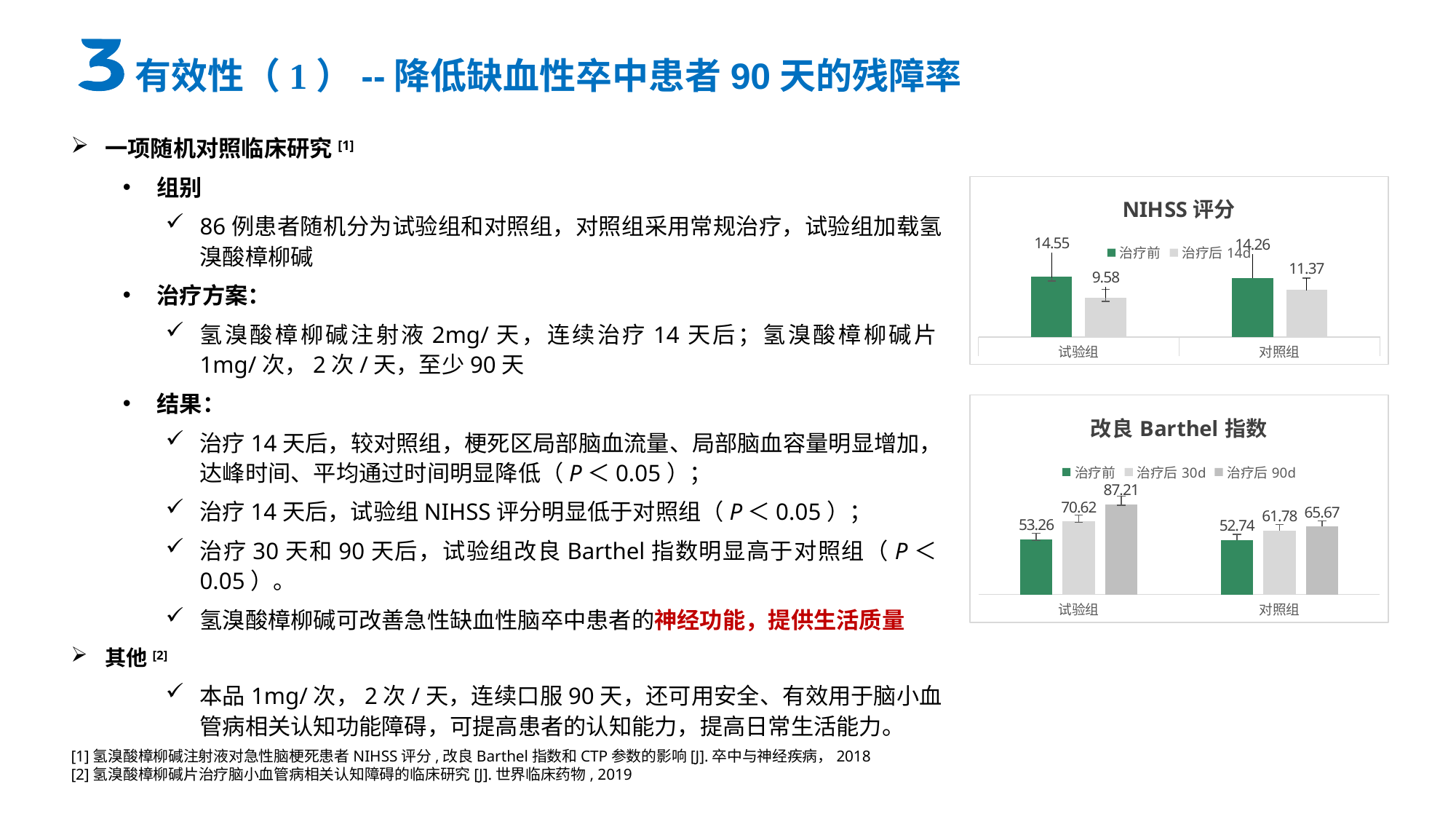
In the 改良 Barthel 指数 chart, do the values for 试验组 rise or fall from 治疗前 to 治疗后 90d? rise In the NIHSS 评分 chart, what is the 治疗后 value for 对照组? 11.37 In the NIHSS 评分 chart, which group has the lower 治疗后 value? 试验组 In the NIHSS 评分 chart, what is the difference between the 治疗前 and 治疗后 values for 试验组? 4.97 In the 改良 Barthel 指数 chart, what is the 治疗后 30d value for 对照组? 61.78 In the 改良 Barthel 指数 chart, which bar has the highest value? 试验组 治疗后 90d In the NIHSS 评分 chart, what is the 治疗前 value for 试验组? 14.55 In the NIHSS 评分 chart, how many groups are shown on the x axis? 2 In the 改良 Barthel 指数 chart, what is the 治疗后 90d value for 试验组? 87.21 What type of chart is the 改良 Barthel 指数 chart? bar chart In the 改良 Barthel 指数 chart, how many series does the legend list? 3 In the 改良 Barthel 指数 chart, what is the difference between the 治疗后 90d values of 试验组 and 对照组? 21.54